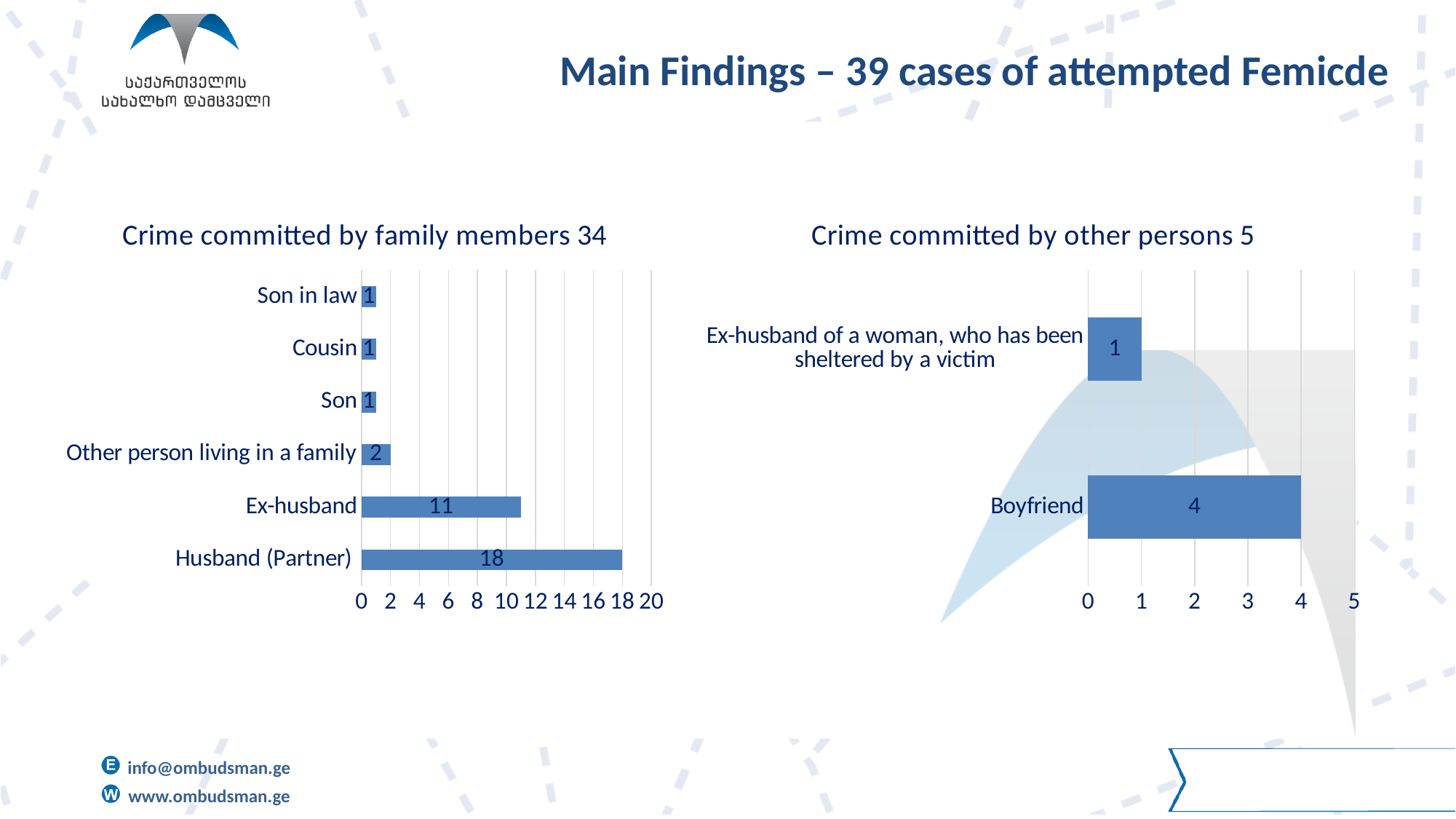
In the 'Crime committed by family members 34' chart, which category has the highest value? Husband (Partner) In the 'Crime committed by family members 34' chart, what is the value for Husband (Partner)? 18 In the 'Crime committed by family members 34' chart, is the value for Husband (Partner) greater or less than 16? greater In the 'Crime committed by family members 34' chart, what is the value for Other person living in a family? 2 In the 'Crime committed by family members 34' chart, how many categories are shown? 6 What type of chart is the 'Crime committed by family members 34' chart? Bar chart In the 'Crime committed by other persons 5' chart, which category has the lowest value? Ex-husband of a woman, who has been sheltered by a victim In the 'Crime committed by other persons 5' chart, what is the value for Boyfriend? 4 In the 'Crime committed by other persons 5' chart, how many categories are shown? 2 In the 'Crime committed by family members 34' chart, what is the difference between Husband (Partner) and Ex-husband? 7 In the 'Crime committed by other persons 5' chart, what is the value for 'Ex-husband of a woman, who has been sheltered by a victim'? 1 In the 'Crime committed by family members 34' chart, what is the value for Ex-husband? 11